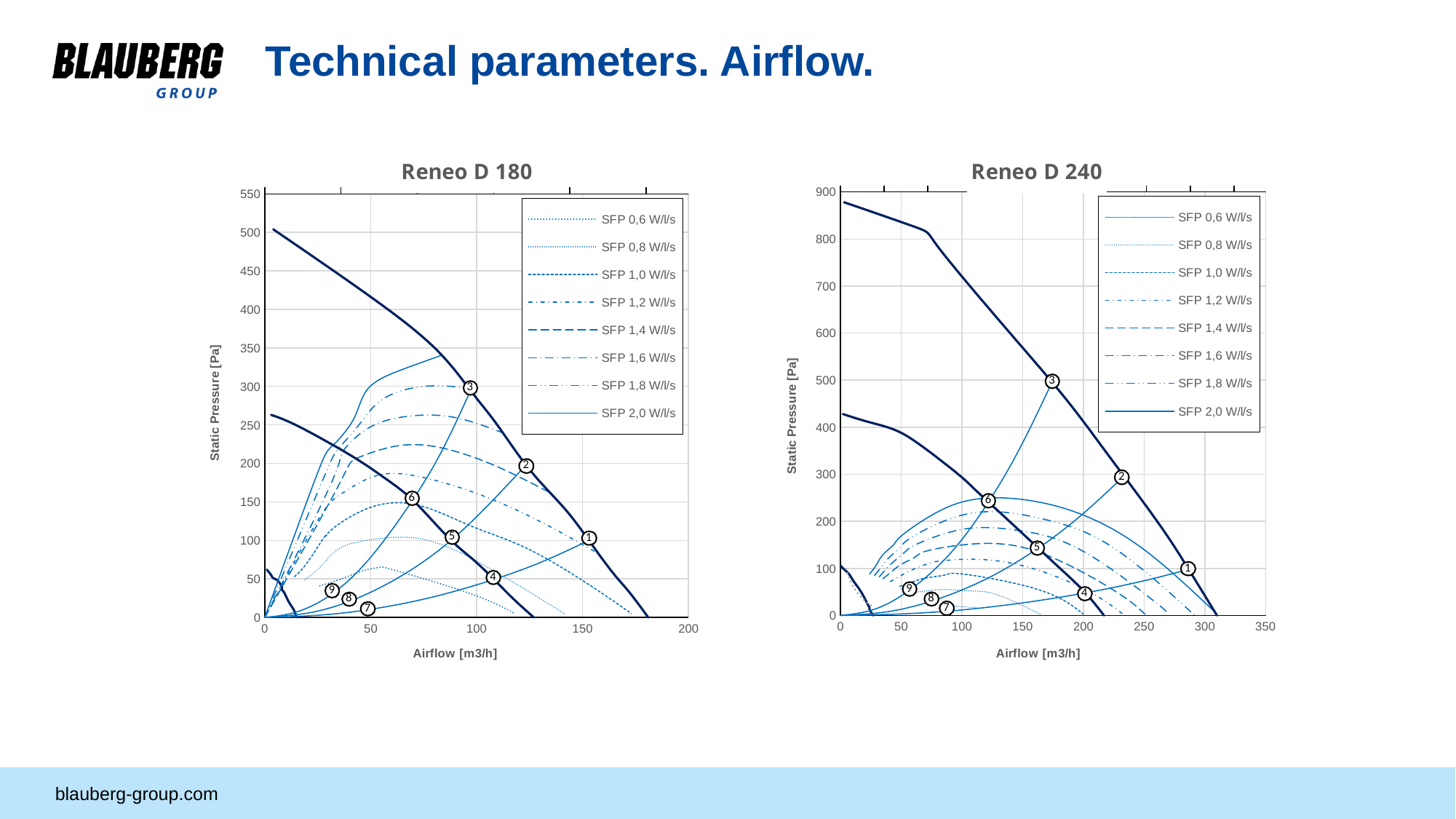
On the Reneo D 180 chart, is the static pressure at numbered point 3 greater or less than 250? greater On the Reneo D 240 chart, is the static pressure at numbered point 7 greater or less than 50? less On the Reneo D 180 chart, which numbered point has the highest static pressure? point 3 What is the label of the x axis on the Reneo D 240 chart? Airflow [m3/h] On the Reneo D 240 chart, which numbered point has the higher static pressure, point 2 or point 3? point 3 What is the label of the y axis on the Reneo D 180 chart? Static Pressure [Pa] On the Reneo D 180 chart, is the airflow at numbered point 1 greater or less than 100? greater What kind of chart is the Reneo D 180 chart? line chart How many series does the legend of the Reneo D 240 chart list? 8